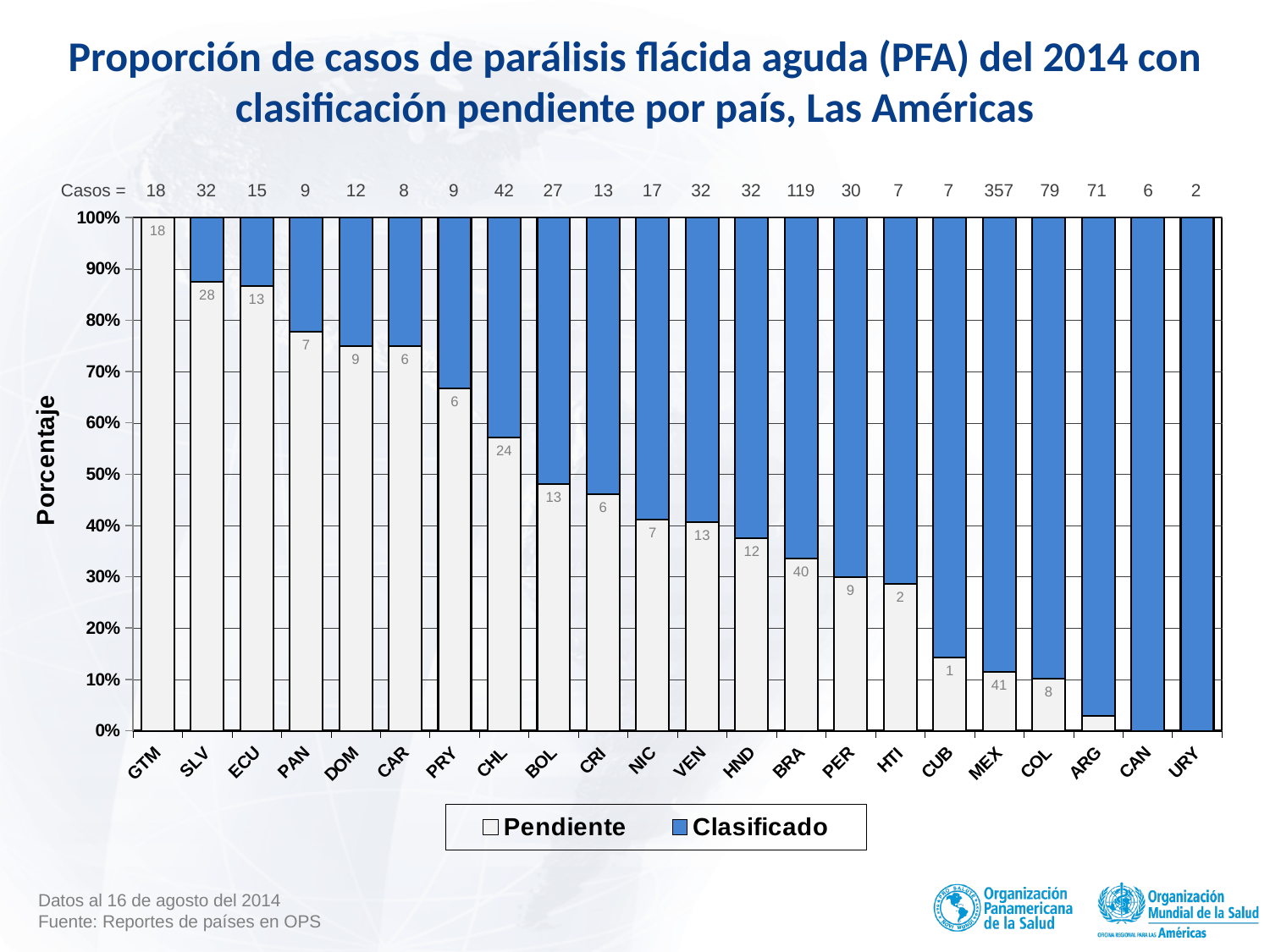
Which country has the highest proportion of Pendiente cases? GTM What is the total number of cases (Casos) shown for CHL? 42 Is the Pendiente proportion for PRY greater or less than 60%? greater How many countries are shown on the x axis? 22 What number is printed on the Pendiente segment for MEX? 41 What is the total number of cases (Casos) shown for MEX? 357 Which has a larger Pendiente proportion, SLV or HND? SLV What number is printed on the Pendiente segment for BRA? 40 Is the Pendiente proportion for CUB greater or less than 20%? less What are the two legend entries of the chart? Pendiente and Clasificado How many series does the legend list? 2 What kind of chart is shown on the slide? stacked bar chart